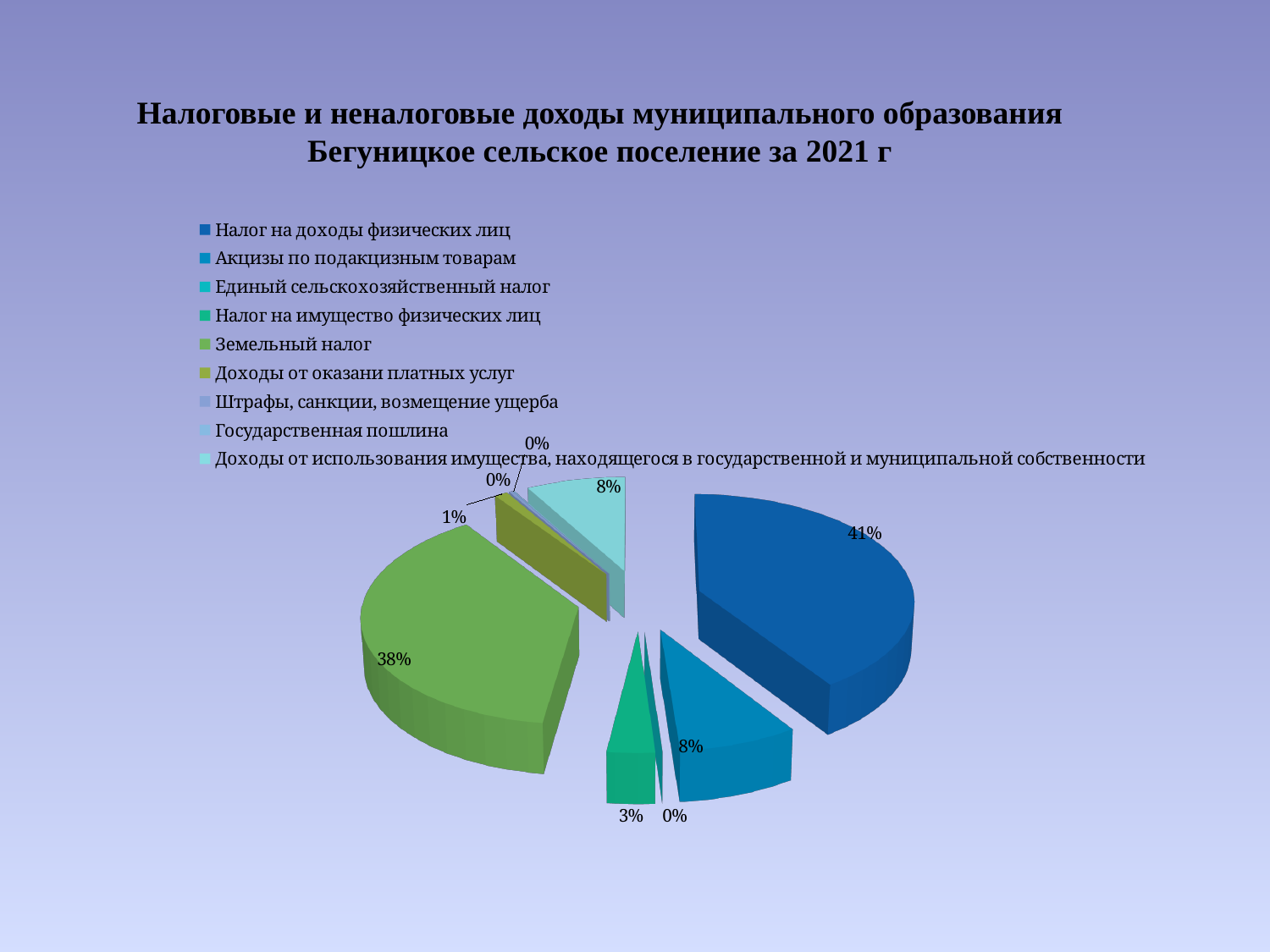
Which category has the largest share of the pie? Налог на доходы физических лиц What is the title of the chart? Налоговые и неналоговые доходы муниципального образования Бегуницкое сельское поселение за 2021 г What share of the pie does "Налог на имущество физических лиц" have? 3% What share of the pie does "Акцизы по подакцизным товарам" have? 8% How many entries does the legend list? 9 Which is larger: the share for "Налог на доходы физических лиц" or the share for "Земельный налог"? Налог на доходы физических лиц What is the difference between the share for "Налог на доходы физических лиц" and the share for "Земельный налог"? 3% What share of the pie does "Доходы от оказани платных услуг" have? 1% What kind of chart is shown on the slide? pie chart